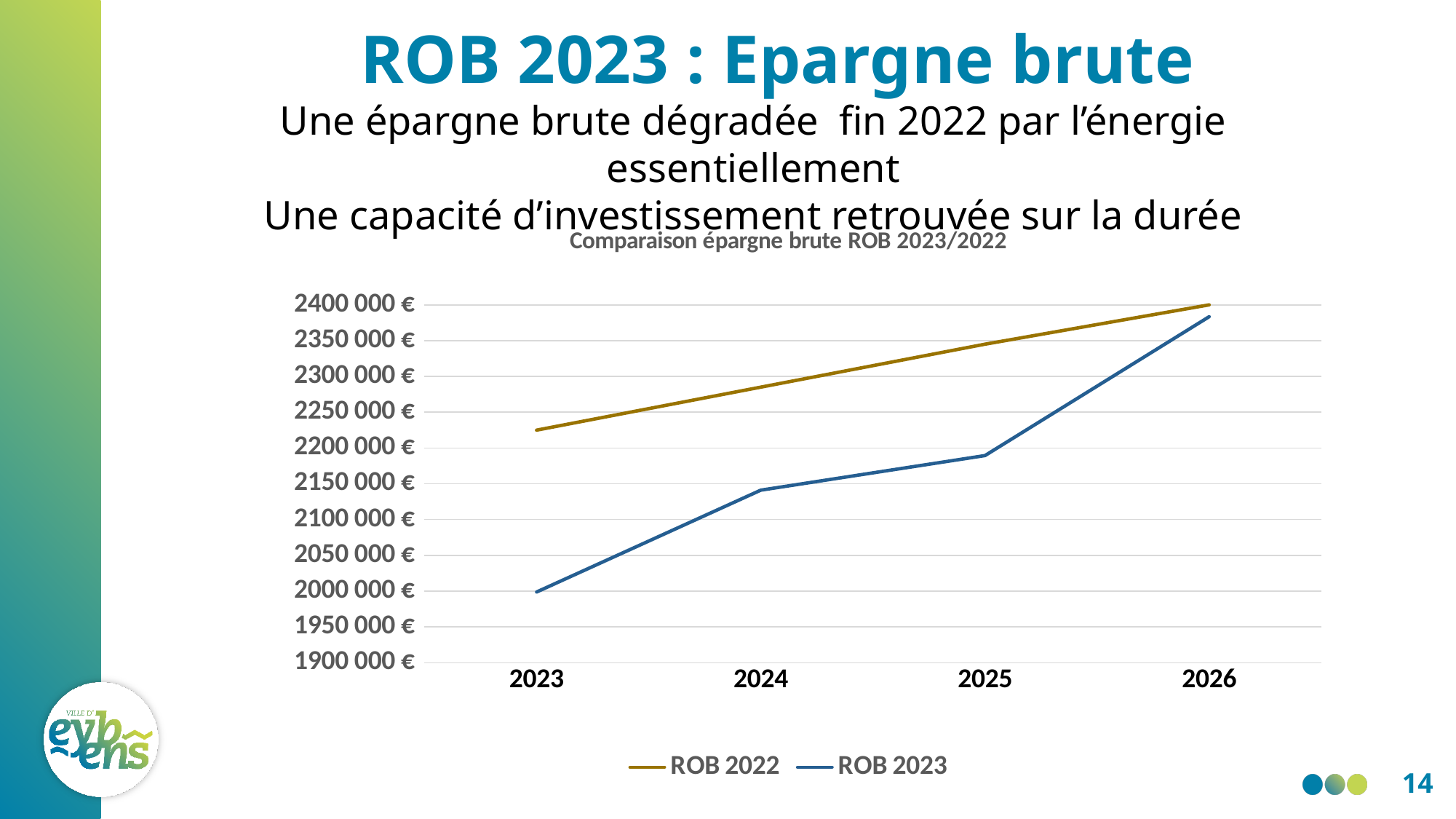
Which series is drawn in blue? ROB 2023 Does the ROB 2023 line rise or fall from 2023 to 2026? Rises How many series does the chart legend list? 2 Is the ROB 2023 value for 2024 greater or less than 2150 000 €? less In 2023, which series has the higher value, ROB 2022 or ROB 2023? ROB 2022 Is the ROB 2022 value for 2024 greater or less than 2300 000 €? less What is the title of the chart? Comparaison épargne brute ROB 2023/2022 Does the ROB 2022 line rise or fall from 2023 to 2026? Rises What kind of chart is shown on the slide? Line chart Is the ROB 2023 value for 2025 greater or less than 2200 000 €? less How many years are plotted along the x axis? 4